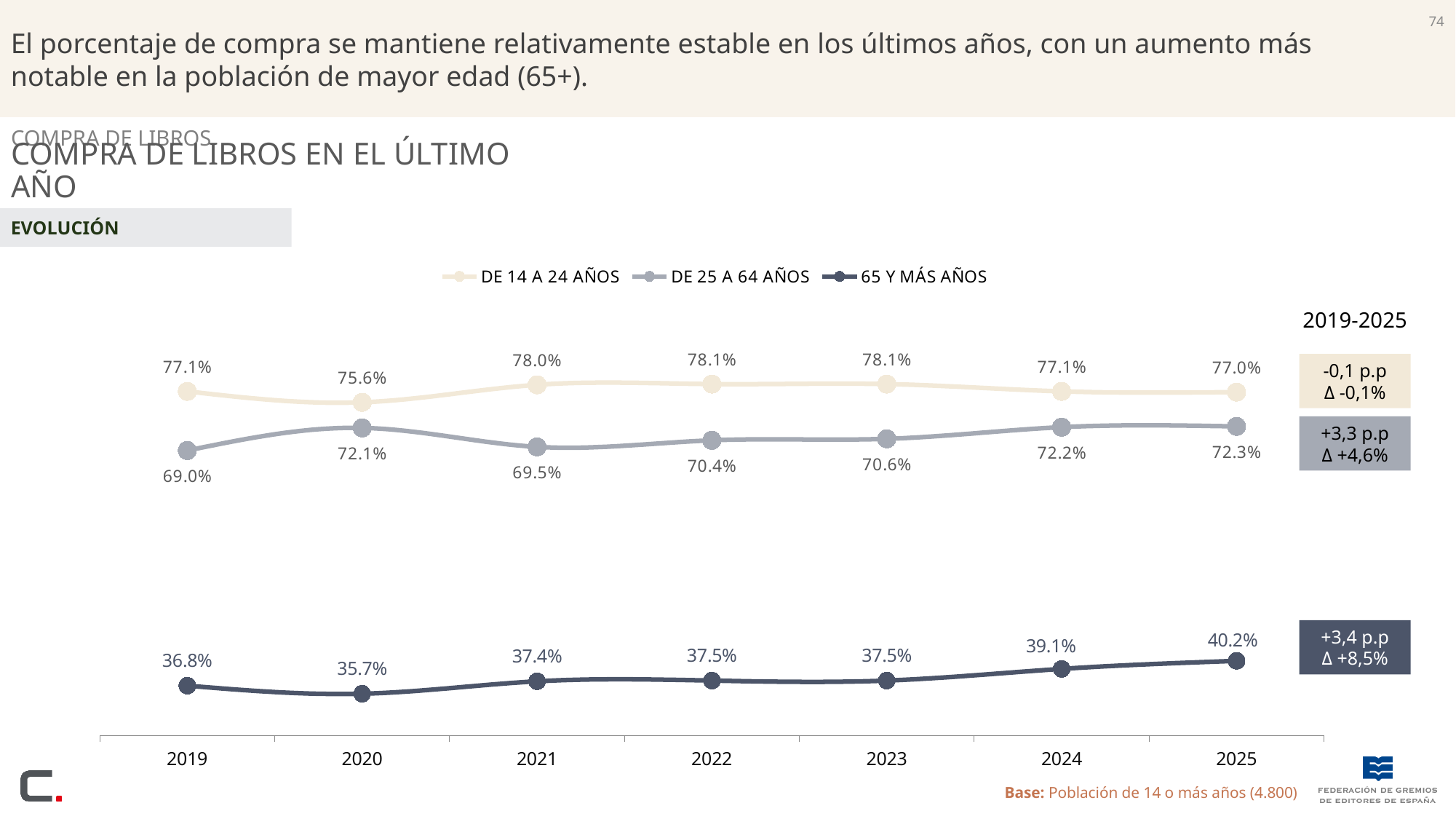
What is the value for 65 Y MÁS AÑOS in 2025? 40.2% How many series does the legend list? 3 Does the value for 65 Y MÁS AÑOS rise or fall from 2023 to 2025? Rise What is the value for 65 Y MÁS AÑOS in 2020? 35.7% What is the value for DE 14 A 24 AÑOS in 2021? 78.0% What is the difference between the DE 14 A 24 AÑOS value and the 65 Y MÁS AÑOS value in 2025? 36.8 percentage points How many years are shown on the x axis? 7 What is the value for DE 25 A 64 AÑOS in 2019? 69.0% In which year is the value for DE 25 A 64 AÑOS highest? 2025 In which year is the value for 65 Y MÁS AÑOS lowest? 2020 What kind of chart is shown on the slide? Line chart Which series has the larger value in 2024, DE 25 A 64 AÑOS or 65 Y MÁS AÑOS? DE 25 A 64 AÑOS